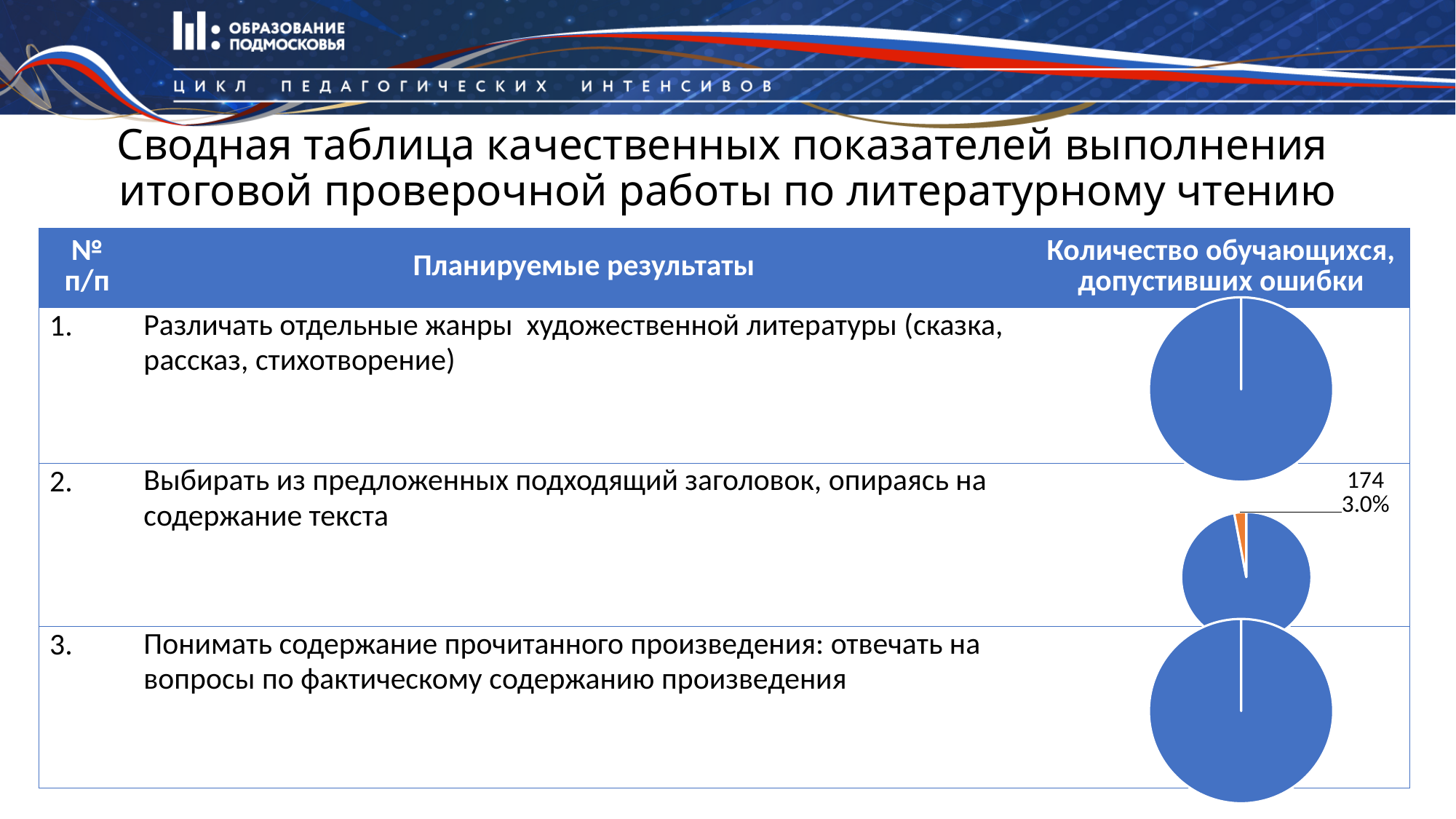
In the pie chart for row 2, which slice is larger, the blue one or the orange one? blue In the pie chart for row 2, what percentage share is printed for the small orange slice? 3.0% What colour is the dominant slice in the pie chart for row 2? blue What colour fills the pie chart for row 3 ("Понимать содержание прочитанного произведения")? blue How many slices are visible in the pie chart for row 2? 2 What kind of chart is shown in the right-hand column for row 1 ("Различать отдельные жанры художественной литературы")? pie chart How many pie charts are shown on the slide? 3 In the pie chart for row 2, what value is printed on the data label of the small orange slice? 174 What kind of chart is shown in the right-hand column for row 2 ("Выбирать из предложенных подходящий заголовок...")? pie chart